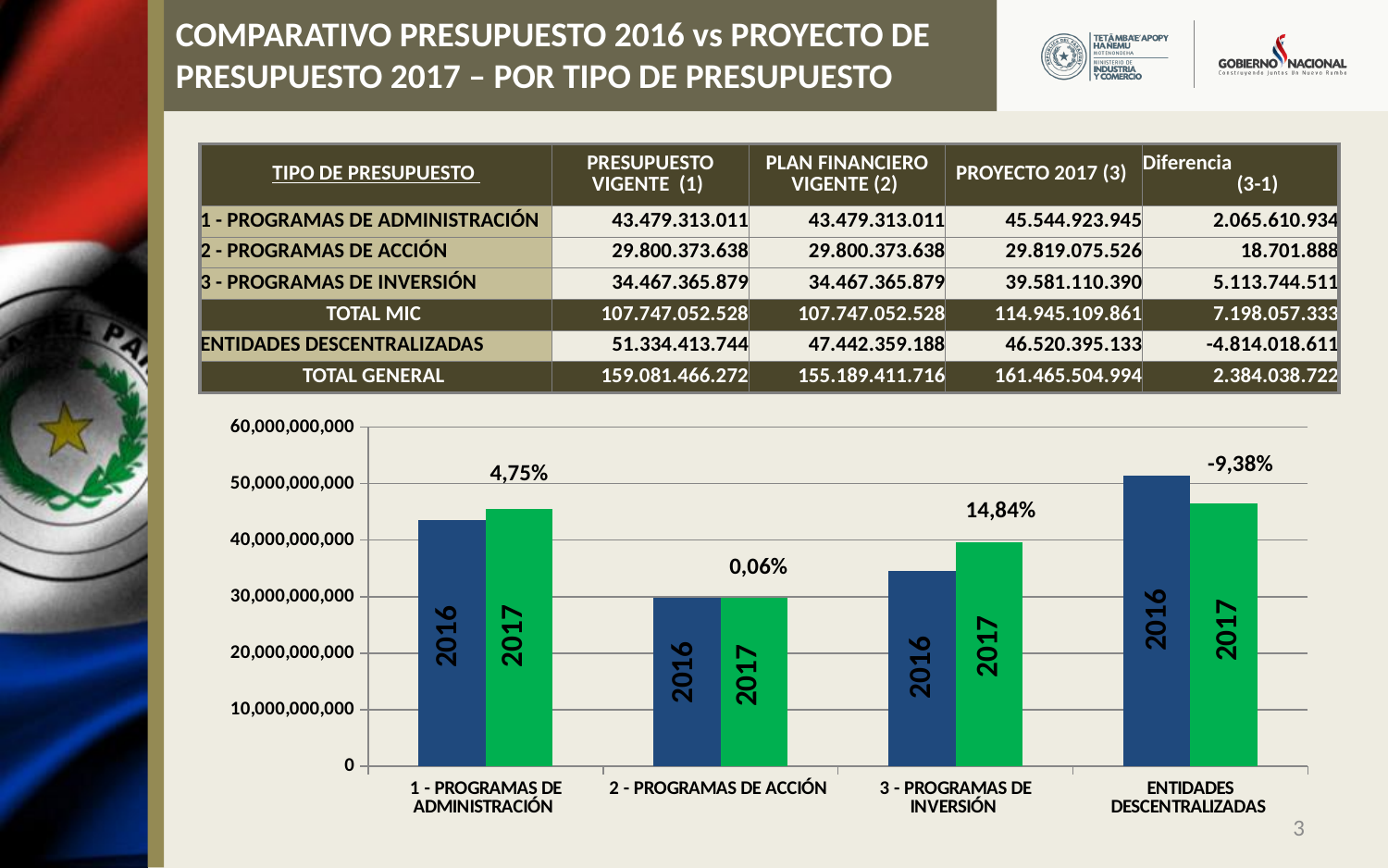
Which category has the smallest percentage label in the bar chart? ENTIDADES DESCENTRALIZADAS Is the 2016 bar for 1 - PROGRAMAS DE ADMINISTRACIÓN greater or less than 40,000,000,000? greater What percentage label is shown above the bars for 1 - PROGRAMAS DE ADMINISTRACIÓN? 4,75% Is the 2017 bar for ENTIDADES DESCENTRALIZADAS greater or less than 50,000,000,000? less How many years (series) are compared for each category in the bar chart? 2 Which category has the tallest 2016 bar in the chart? ENTIDADES DESCENTRALIZADAS Which category has the shortest 2017 bar in the chart? 2 - PROGRAMAS DE ACCIÓN What percentage label is shown above the bars for 3 - PROGRAMAS DE INVERSIÓN? 14,84% For ENTIDADES DESCENTRALIZADAS, which bar is taller, 2016 or 2017? 2016 How many categories are shown on the x axis of the bar chart? 4 What percentage label is shown above the bars for ENTIDADES DESCENTRALIZADAS? -9,38% What kind of chart is shown below the table? bar chart